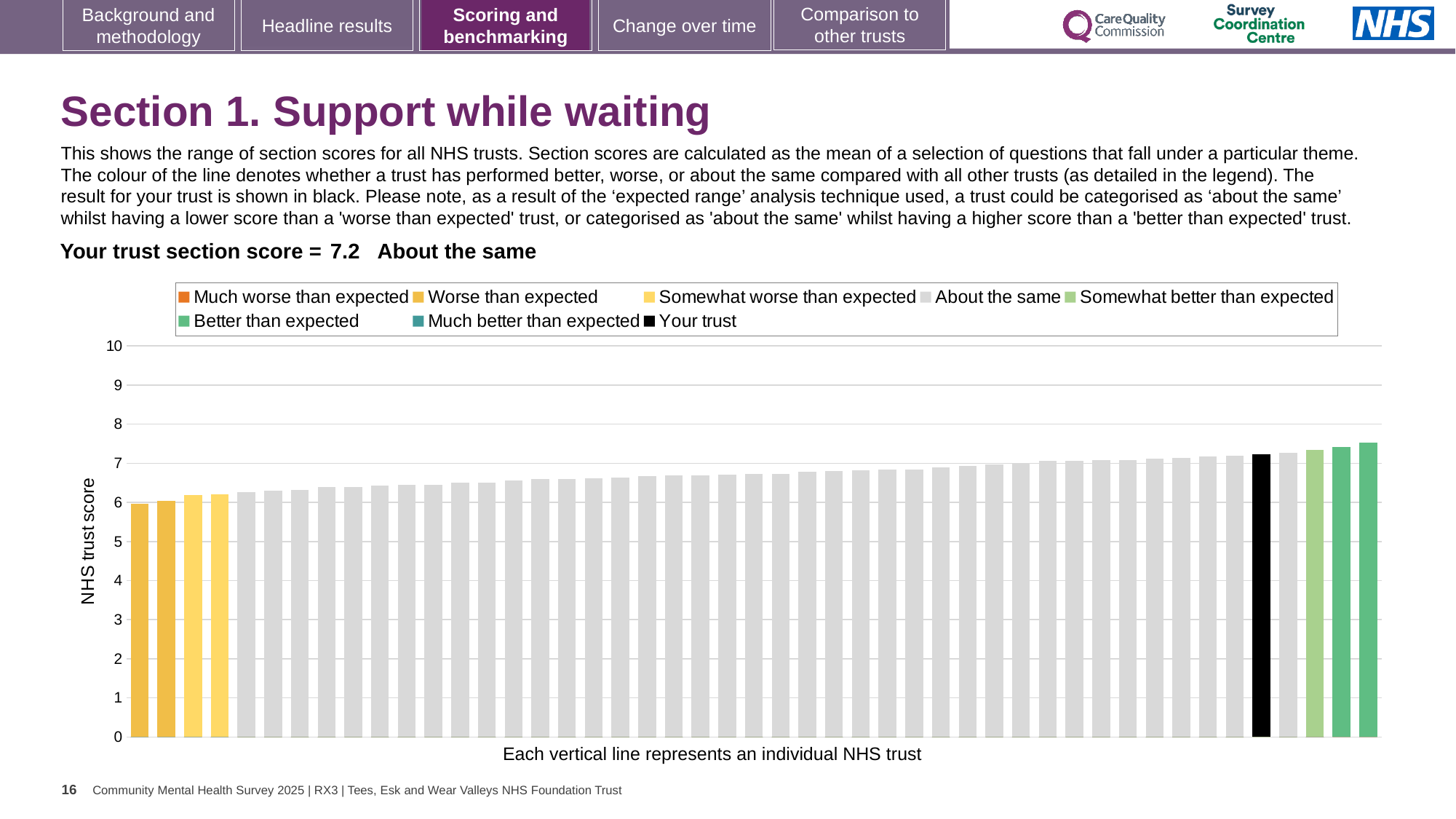
Is the value of the leftmost (lowest) bar greater or less than 7? less What kind of chart is shown on the slide? Bar chart Is the value of the tallest bar greater or less than 7? greater Do the bar values rise or fall from left to right along the x axis? rise What colour is the bar representing your trust? Black Is the value of the black 'Your trust' bar greater or less than 7? greater How many entries does the chart legend list? 8 How many bars are coloured as 'Better than expected' (green)? 2 What is the title of the vertical axis? NHS trust score What is the section score for your trust shown on the slide? 7.2 Which category is your trust placed in for this section? About the same